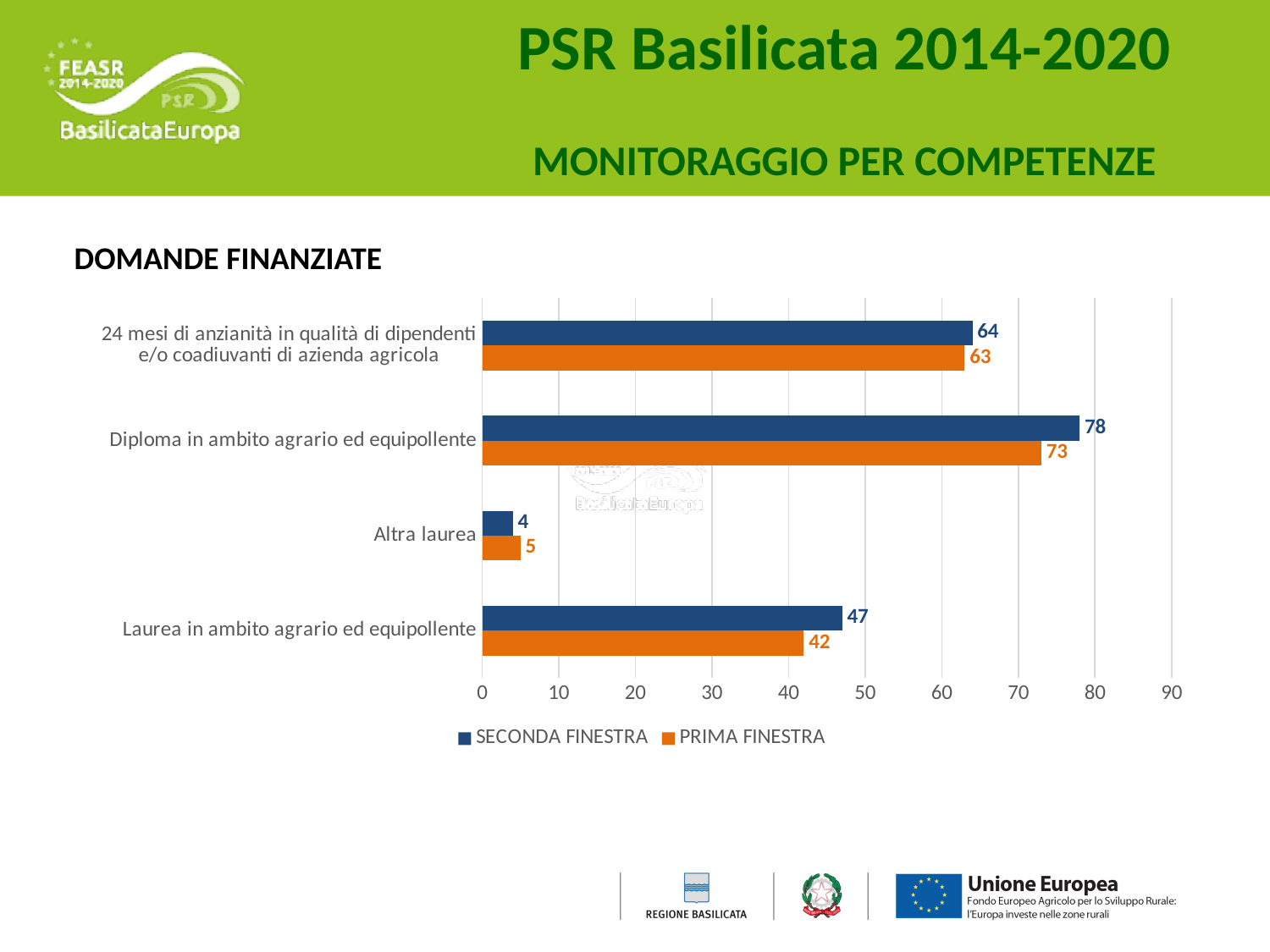
What is the PRIMA FINESTRA value for Altra laurea? 5 Is the SECONDA FINESTRA value for Laurea in ambito agrario ed equipollente greater or less than 40? greater What is the difference between the SECONDA FINESTRA and PRIMA FINESTRA values for Diploma in ambito agrario ed equipollente? 5 Which category has the lowest PRIMA FINESTRA value? Altra laurea For Altra laurea, which is larger: SECONDA FINESTRA or PRIMA FINESTRA? PRIMA FINESTRA What is the SECONDA FINESTRA value for Diploma in ambito agrario ed equipollente? 78 What is the PRIMA FINESTRA value for Laurea in ambito agrario ed equipollente? 42 What is the title of the chart? DOMANDE FINANZIATE What kind of chart is shown on the slide? bar chart How many series does the legend list? 2 How many categories are shown on the chart? 4 Which category has the highest SECONDA FINESTRA value? Diploma in ambito agrario ed equipollente